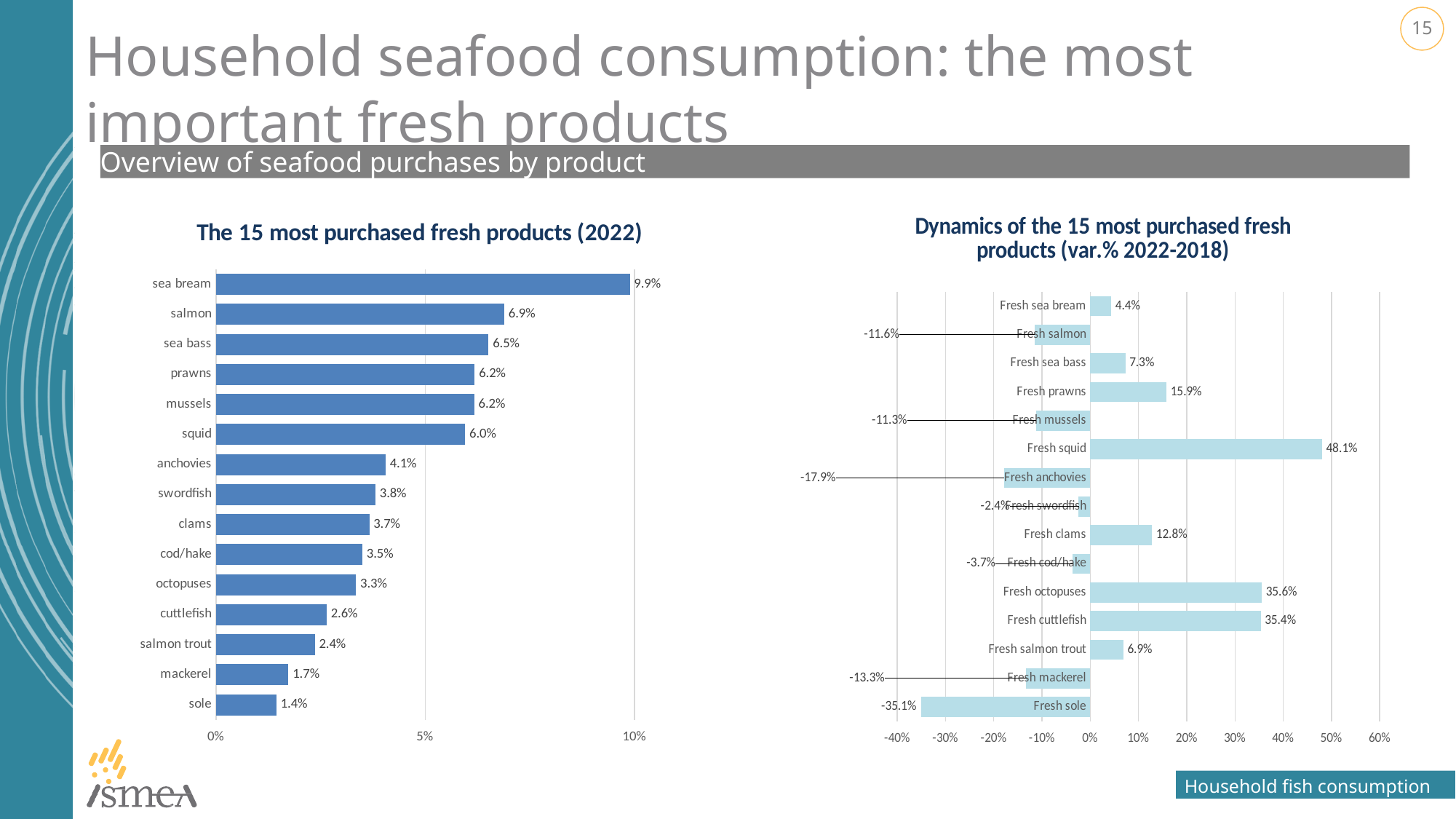
In the chart 'The 15 most purchased fresh products (2022)', which is larger, the value for anchovies or the value for clams? anchovies In the chart 'The 15 most purchased fresh products (2022)', what is the value for sea bream? 9.9% In the chart 'The 15 most purchased fresh products (2022)', how many products are shown? 15 In the chart 'Dynamics of the 15 most purchased fresh products (var.% 2022-2018)', what is the difference between the values for Fresh octopuses and Fresh cuttlefish? 0.2% In the chart 'The 15 most purchased fresh products (2022)', which product has the lowest value? sole What kind of chart is 'The 15 most purchased fresh products (2022)'? bar chart In the chart 'Dynamics of the 15 most purchased fresh products (var.% 2022-2018)', what is the value for Fresh squid? 48.1% In the chart 'The 15 most purchased fresh products (2022)', what is the difference between the values for salmon and sea bass? 0.4% In the chart 'Dynamics of the 15 most purchased fresh products (var.% 2022-2018)', which product has the lowest value? Fresh sole In the chart 'Dynamics of the 15 most purchased fresh products (var.% 2022-2018)', which is larger, the value for Fresh prawns or the value for Fresh clams? Fresh prawns In the chart 'Dynamics of the 15 most purchased fresh products (var.% 2022-2018)', what is the value for Fresh salmon? -11.6% In the chart 'Dynamics of the 15 most purchased fresh products (var.% 2022-2018)', which product has the highest value? Fresh squid